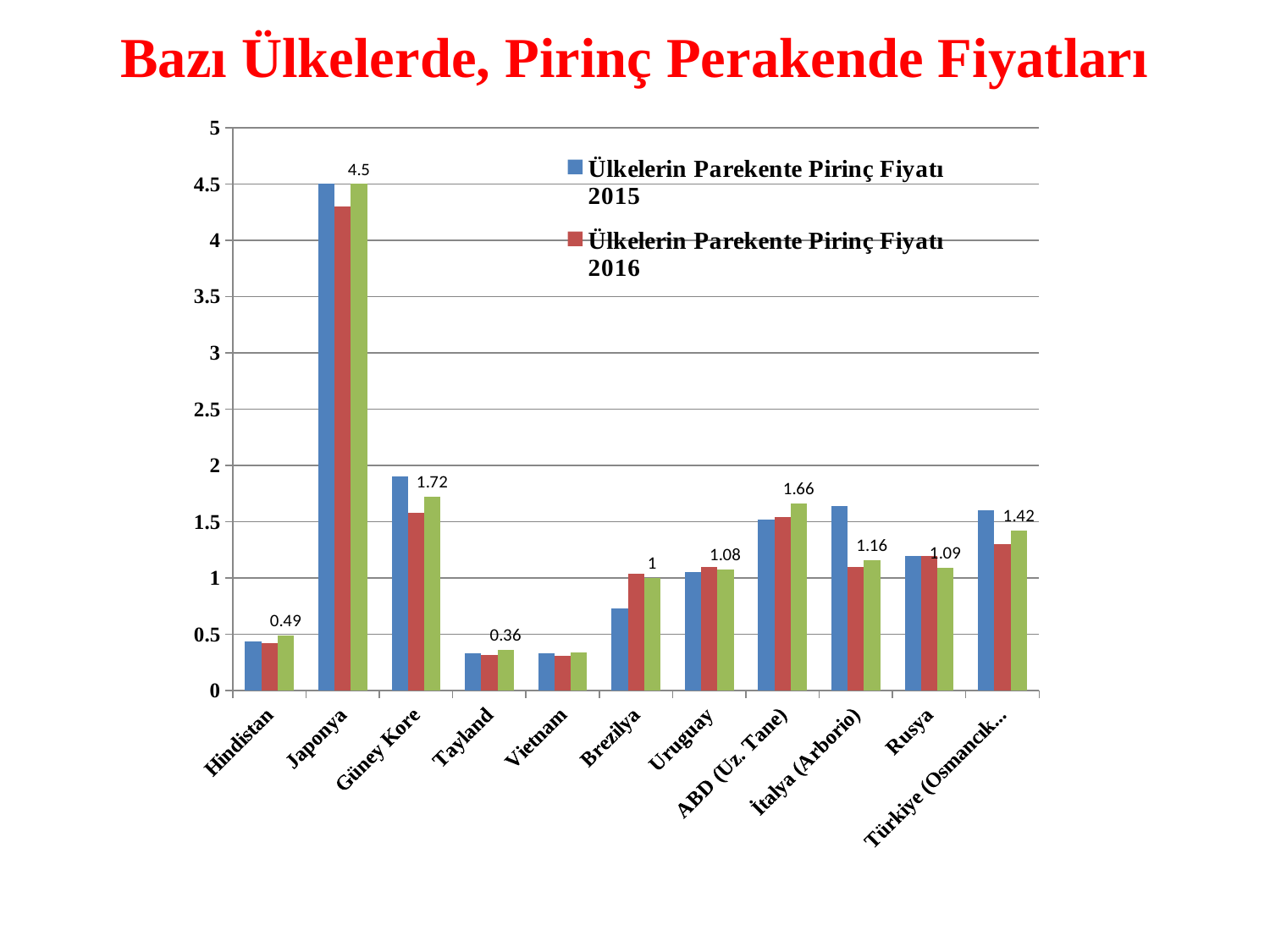
How many countries (categories) are shown on the x axis of the chart? 11 What is the data label printed above the bars for Hindistan? 0.49 Is the 2015 (blue) bar for İtalya (Arborio) greater or less than 1.5? greater What is the data label printed above the bars for Japonya? 4.5 Which has the larger printed data label, Japonya or Güney Kore? Japonya Which country has the highest bars in the chart? Japonya What is the title of the slide containing the chart? Bazı Ülkelerde, Pirinç Perakende Fiyatları What kind of chart is shown on the slide? bar chart Which country has the lowest printed data label in the chart? Tayland What is the difference between the printed data labels for Güney Kore (1.72) and İtalya (Arborio) (1.16)? 0.56 How many series does the chart's legend list? 2 What is the data label printed above the bars for Güney Kore? 1.72